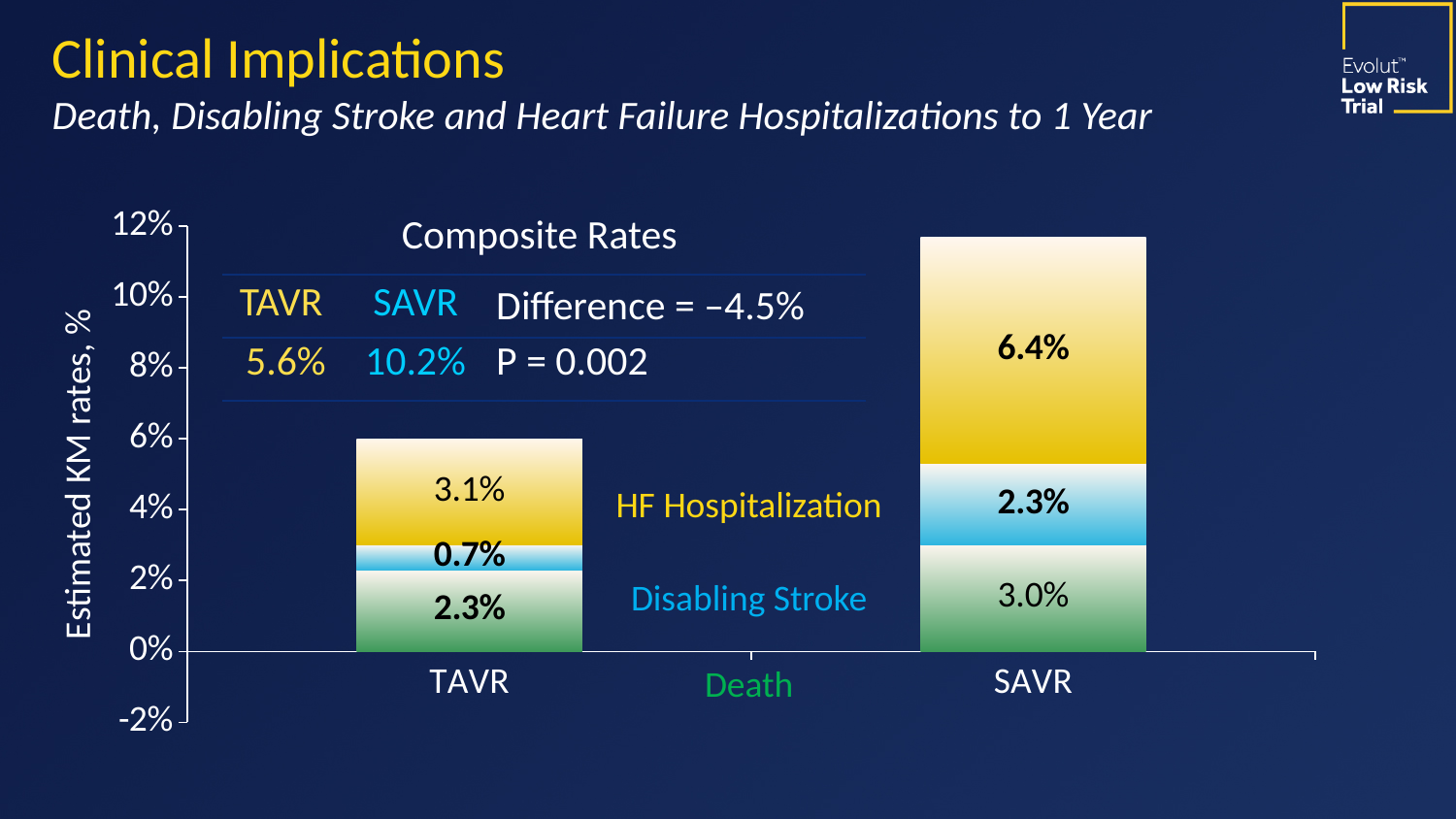
How many series (outcome types) are stacked in each bar? 3 What is the Death rate for TAVR? 2.3% Which group has the higher HF Hospitalization rate, TAVR or SAVR? SAVR What is the Disabling Stroke rate for SAVR? 2.3% How many bars are shown in the chart? 2 What is the Disabling Stroke rate for TAVR? 0.7% What is the difference between the HF Hospitalization rates for SAVR and TAVR? 3.3% Which segment is the largest in the SAVR bar? HF Hospitalization What is the HF Hospitalization rate for SAVR? 6.4% What is the difference between the Death rates for SAVR and TAVR? 0.7% What is the HF Hospitalization rate for TAVR? 3.1% What type of chart is shown on the slide? Stacked bar chart